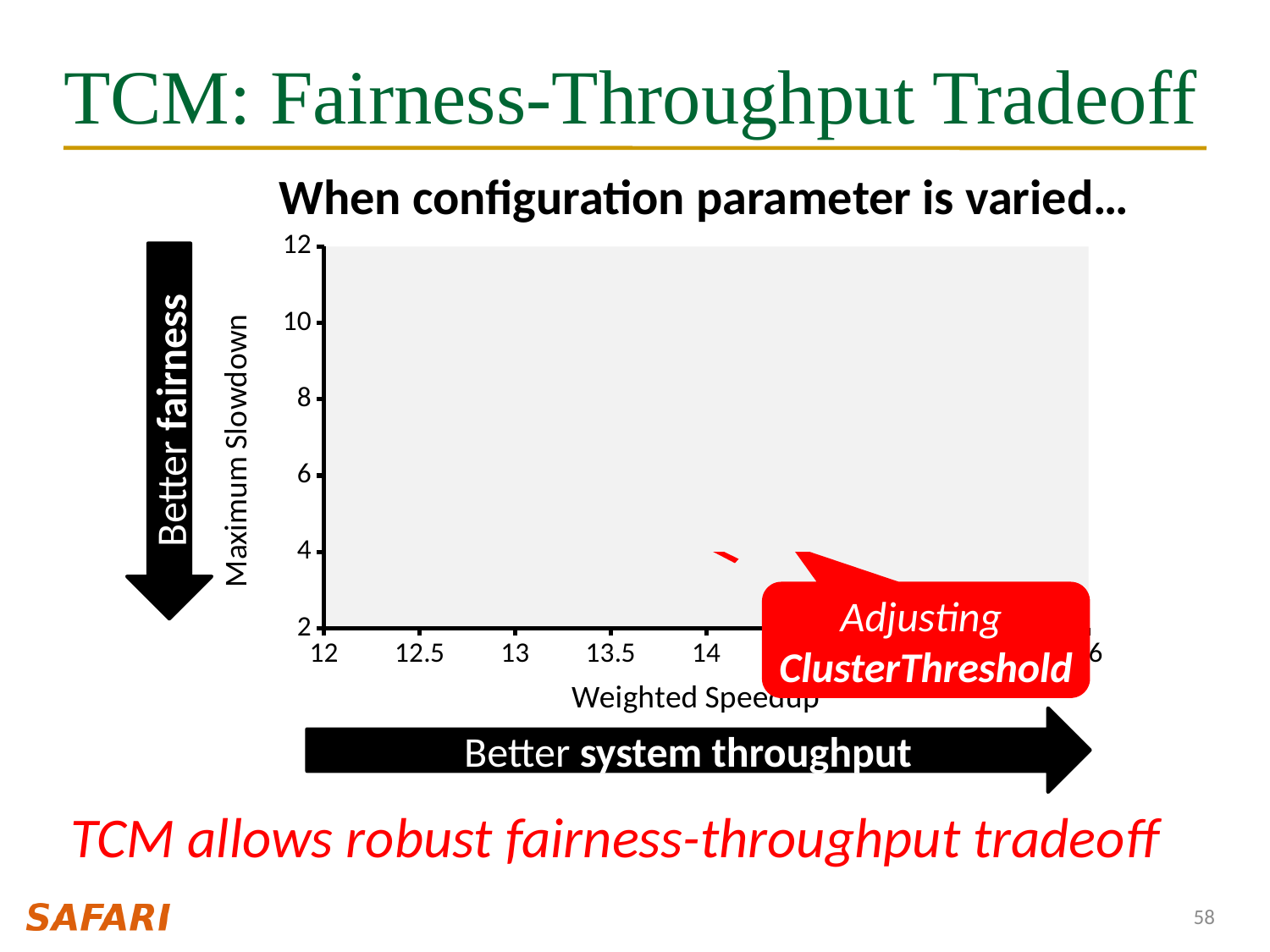
Is the Maximum Slowdown of the visible red data point greater or less than 6? less What is the title of the chart? When configuration parameter is varied… Is the Weighted Speedup of the visible red data point greater or less than 13? greater What is the label of the chart's y axis? Maximum Slowdown